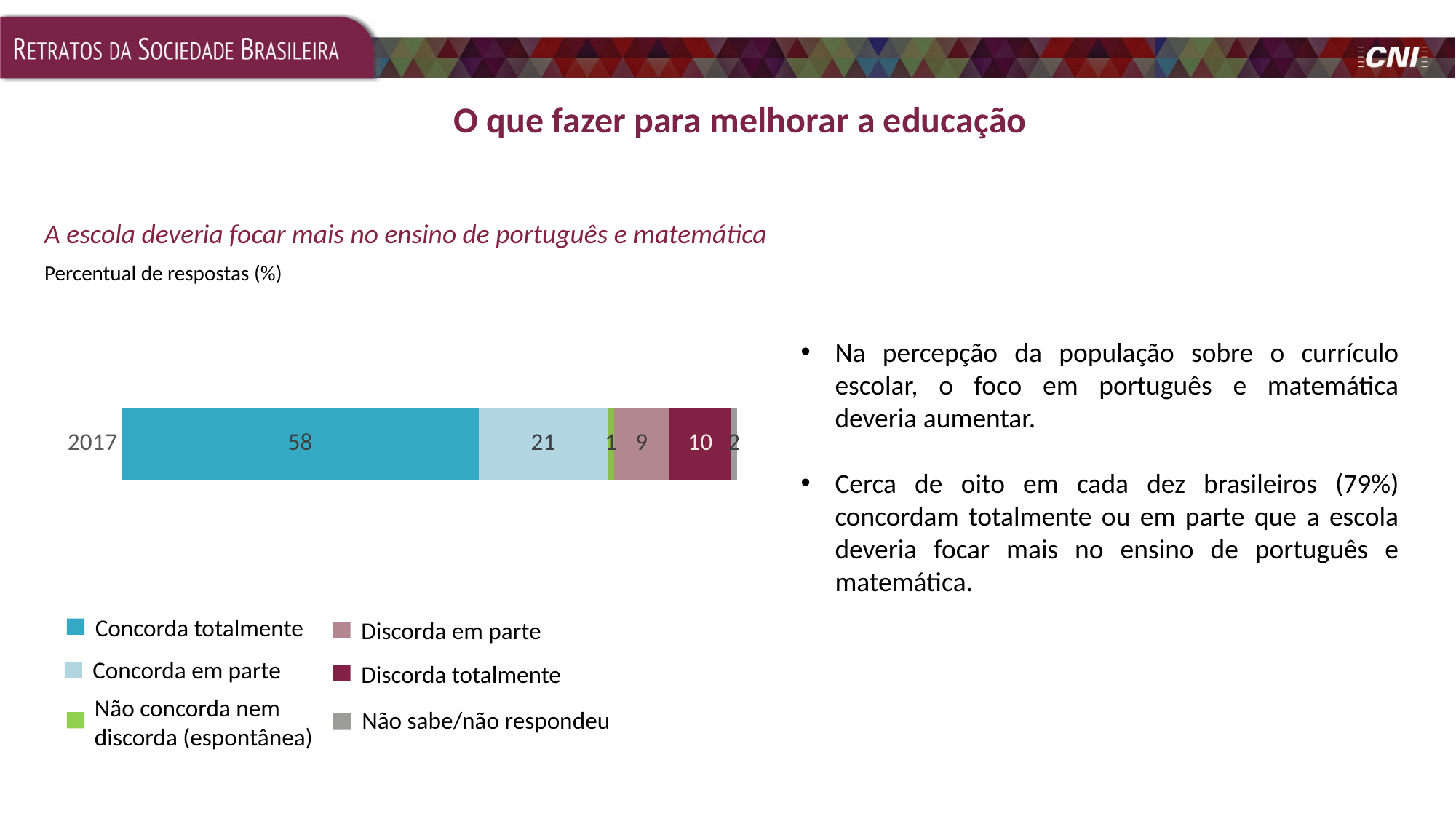
Which response category has the smallest share in the 2017 bar? Não concorda nem discorda (espontânea) What is the difference between the "Concorda totalmente" and "Concorda em parte" values in 2017? 37 Which is larger in 2017: "Discorda em parte" or "Discorda totalmente"? Discorda totalmente What percentage of respondents in 2017 answered "Não sabe/não respondeu"? 2 What percentage of respondents in 2017 answered "Discorda em parte"? 9 How many series does the legend list? 6 What percentage of respondents in 2017 answered "Concorda em parte"? 21 Which response category has the largest share in the 2017 bar? Concorda totalmente What percentage of respondents in 2017 answered "Concorda totalmente"? 58 What type of chart is shown on the slide? Stacked bar chart What percentage of respondents in 2017 answered "Discorda totalmente"? 10 What is the combined total of "Concorda totalmente" and "Concorda em parte" in 2017? 79